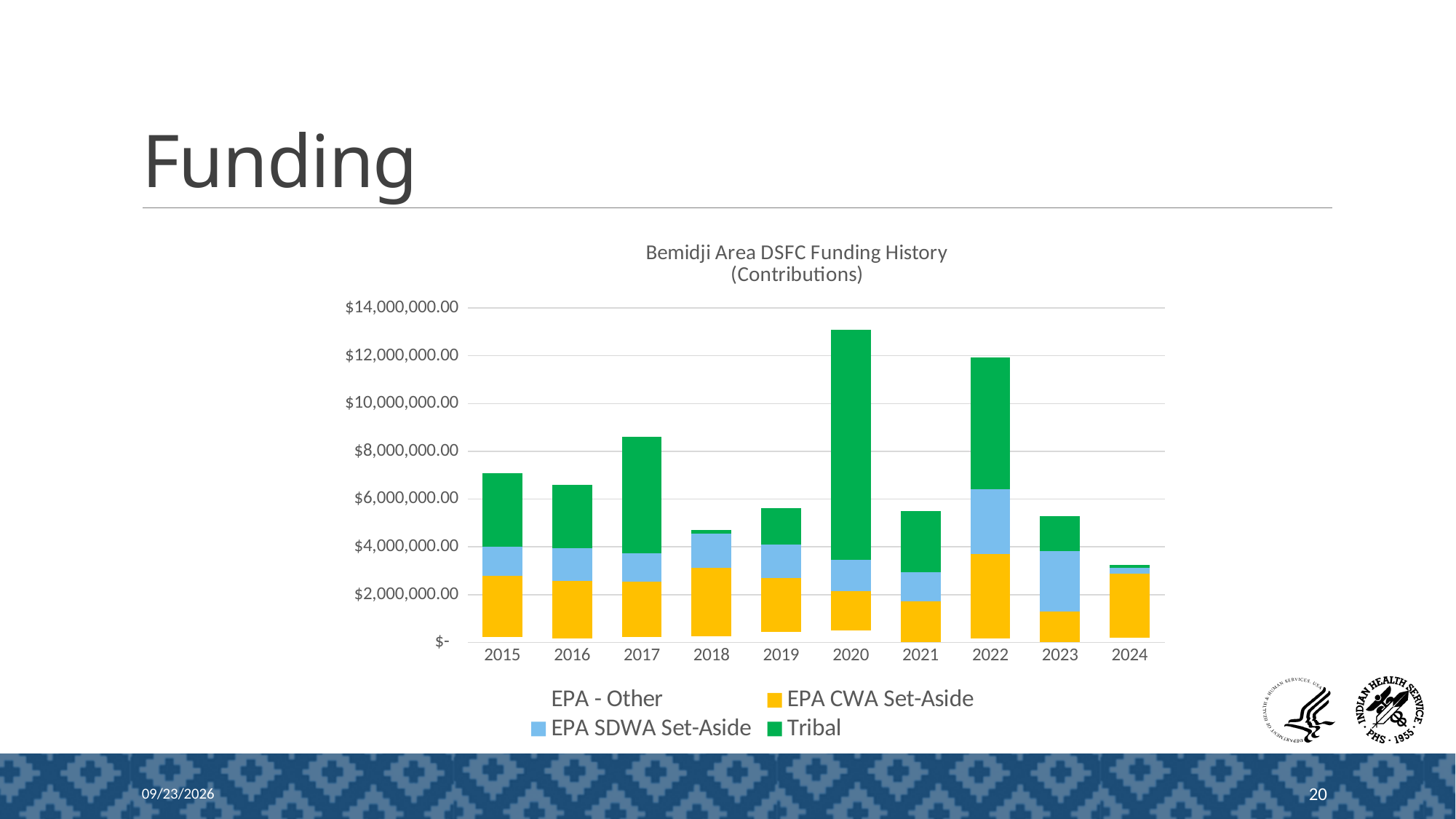
Is the total funding for 2022 greater or less than $10,000,000.00? greater What kind of chart is shown on the slide? Stacked bar chart Which colour represents the Tribal series in the chart? Green Is the total funding for 2021 greater or less than $6,000,000.00? less Is the total funding for 2020 greater or less than $12,000,000.00? greater How many series does the legend list? 4 Which year has the highest total funding? 2020 Which year has the larger total funding, 2020 or 2022? 2020 How many years are shown on the x axis? 10 What is the title of the chart? Bemidji Area DSFC Funding History (Contributions) Which year has the lowest total funding? 2024